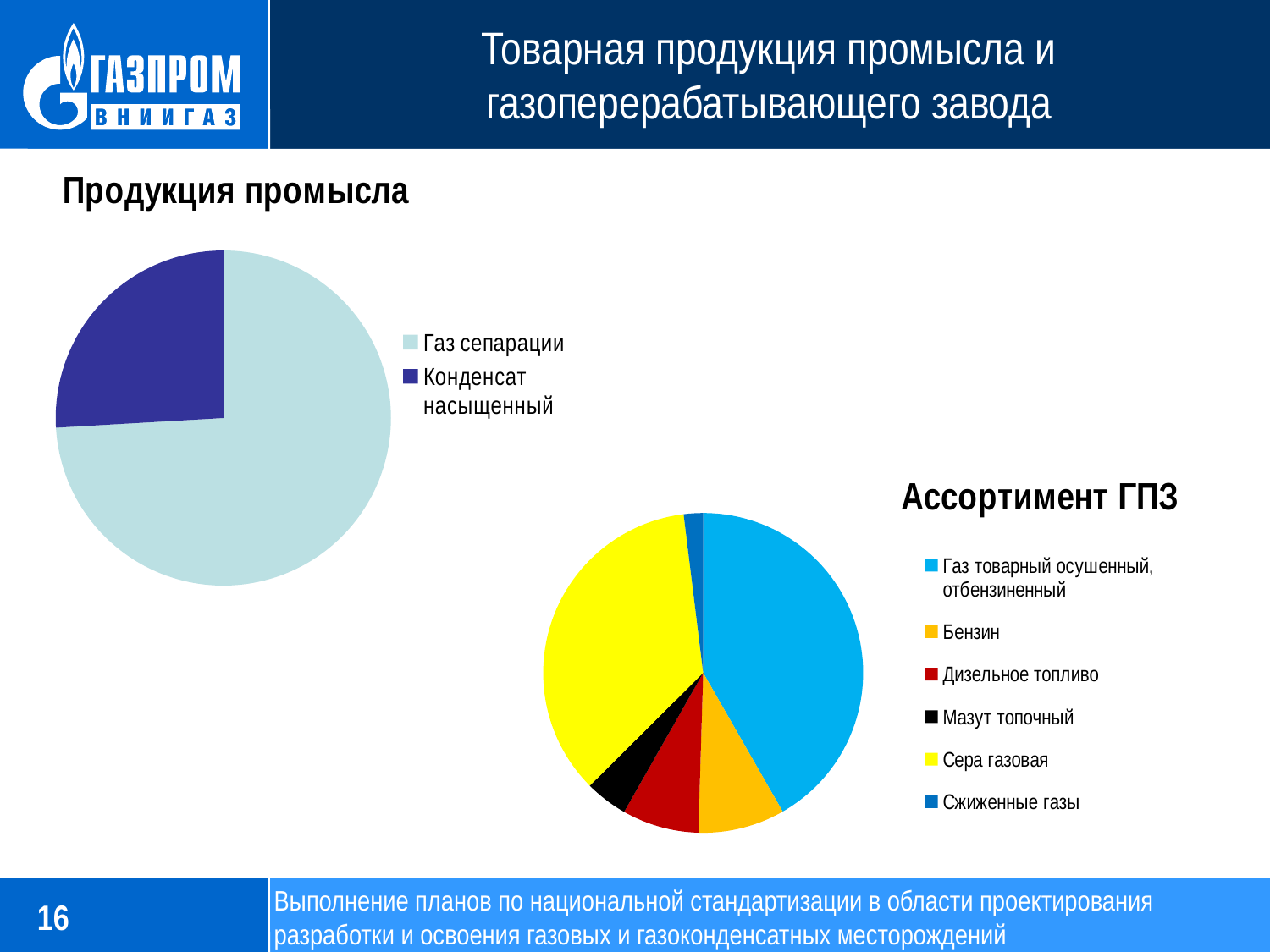
In the "Продукция промысла" chart, which category has the smallest slice? Конденсат насыщенный What is the title of the pie chart in the lower right of the slide? Ассортимент ГПЗ What kind of chart is the "Ассортимент ГПЗ" chart? Pie chart In the "Ассортимент ГПЗ" chart, what colour is the Сера газовая slice? Yellow In the "Продукция промысла" chart, which category has the largest slice? Газ сепарации In the "Ассортимент ГПЗ" chart, which category has the largest slice? Газ товарный осушенный, отбензиненный In the "Продукция промысла" chart, how many slices does the pie have? 2 In the "Ассортимент ГПЗ" chart, how many categories does the legend list? 6 In the "Ассортимент ГПЗ" chart, which category has the smallest slice? Сжиженные газы In the "Ассортимент ГПЗ" chart, which slice is larger: Сера газовая or Бензин? Сера газовая What kind of chart is the "Продукция промысла" chart? Pie chart In the "Ассортимент ГПЗ" chart, which slice is larger: Бензин or Мазут топочный? Бензин